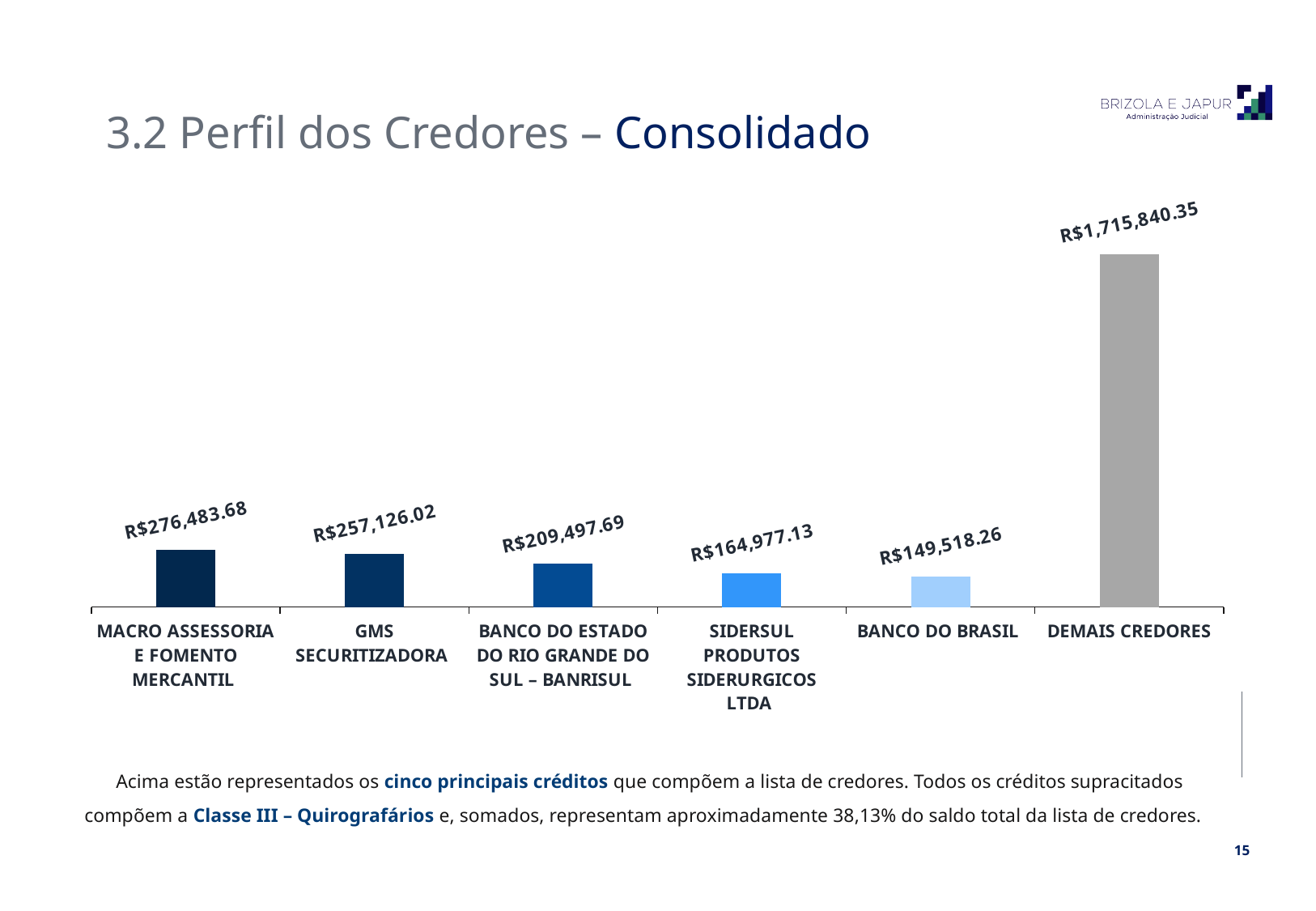
Which is larger, the value for GMS SECURITIZADORA or the value for BANCO DO ESTADO DO RIO GRANDE DO SUL – BANRISUL? GMS SECURITIZADORA What is the value for BANCO DO BRASIL? R$149,518.26 What is the value for GMS SECURITIZADORA? R$257,126.02 What is the value for DEMAIS CREDORES? R$1,715,840.35 Which category has the highest value? DEMAIS CREDORES Which category has the lowest value? BANCO DO BRASIL How many categories are shown in the chart? 6 What kind of chart is shown on the slide? Bar chart What is the difference between the values for BANCO DO ESTADO DO RIO GRANDE DO SUL – BANRISUL and SIDERSUL PRODUTOS SIDERURGICOS LTDA? R$44,520.56 What is the value for SIDERSUL PRODUTOS SIDERURGICOS LTDA? R$164,977.13 What is the difference between the values for MACRO ASSESSORIA E FOMENTO MERCANTIL and GMS SECURITIZADORA? R$19,357.66 Do the values of the five named creditors rise or fall from left to right? Fall